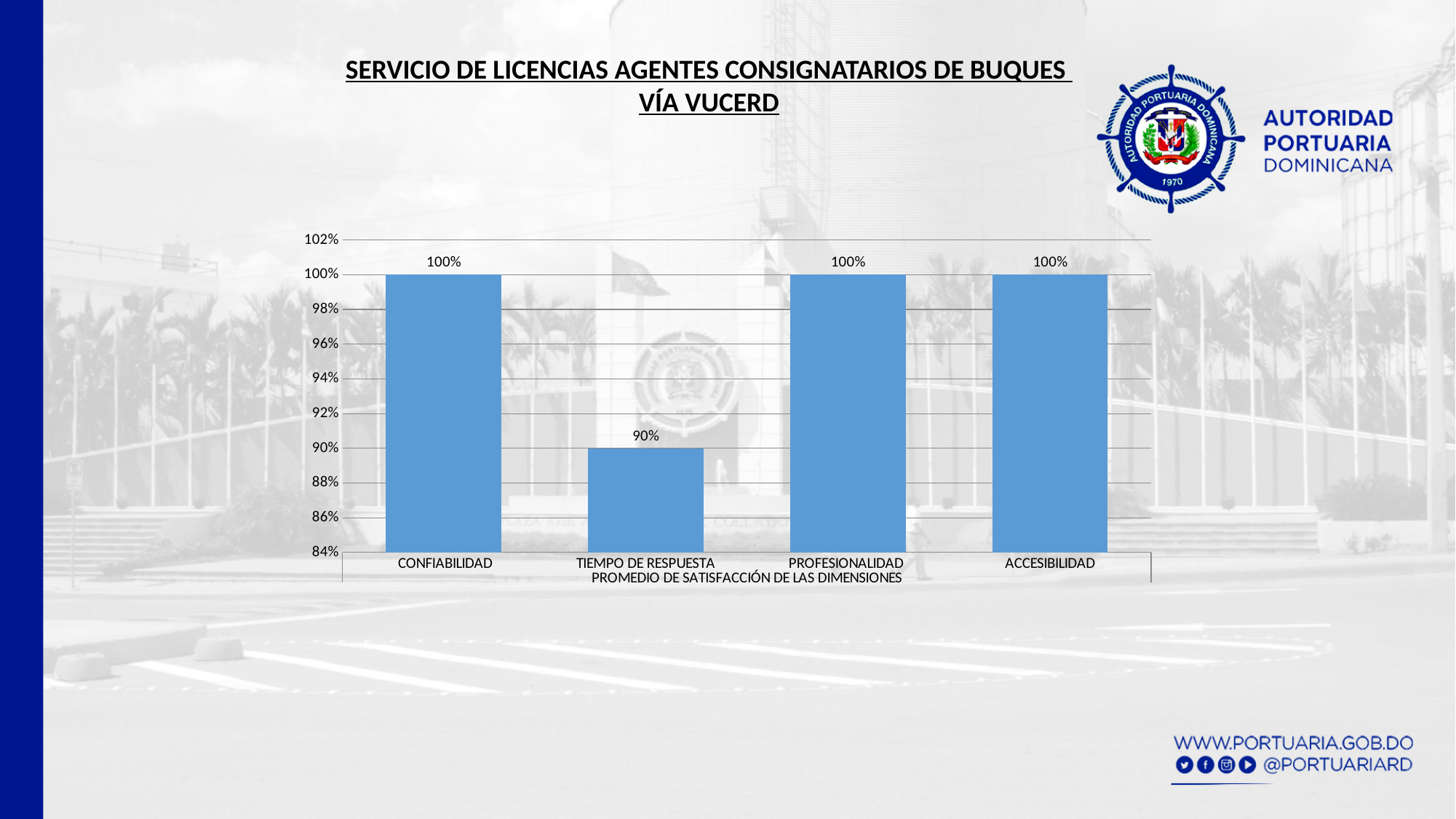
What is the value for TIEMPO DE RESPUESTA? 90% Is the value for TIEMPO DE RESPUESTA greater or less than 96%? less Which category has the lowest value? TIEMPO DE RESPUESTA Which is larger, the value for PROFESIONALIDAD or the value for TIEMPO DE RESPUESTA? PROFESIONALIDAD What kind of chart is shown on the slide? bar chart What is the title of the chart? SERVICIO DE LICENCIAS AGENTES CONSIGNATARIOS DE BUQUES VÍA VUCERD What is the value for PROFESIONALIDAD? 100% What is the value for CONFIABILIDAD? 100% What is the label shown below the category names on the x axis? PROMEDIO DE SATISFACCIÓN DE LAS DIMENSIONES How many categories are shown on the x axis? 4 What is the difference between the values for CONFIABILIDAD and TIEMPO DE RESPUESTA? 10% What is the value for ACCESIBILIDAD? 100%